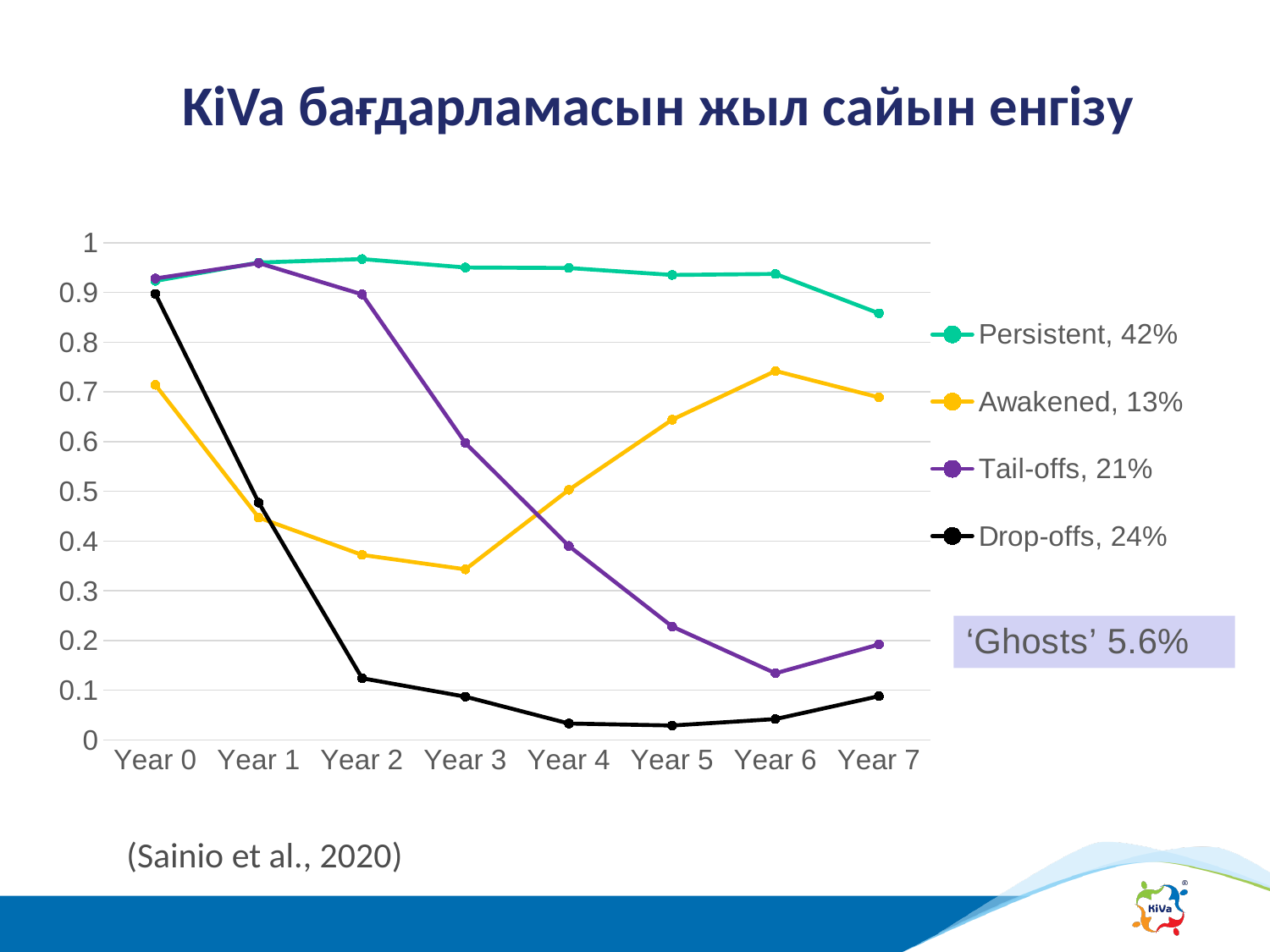
At Year 7, which series has the larger value, Persistent or Drop-offs? Persistent What kind of chart is shown on the slide? line chart Which series has the highest value at Year 5? Persistent Which series has the lowest value at Year 7? Drop-offs Do the values for Drop-offs rise or fall from Year 0 to Year 4? fall What percentage is shown next to Persistent in the legend? 42% Is the value for Tail-offs at Year 3 greater or less than 0.5? greater How many series does the legend list? 4 Is the value for Awakened at Year 6 greater or less than 0.7? greater How many year categories are shown on the x axis? 8 At Year 4, which series has the larger value, Awakened or Tail-offs? Awakened Is the value for Drop-offs at Year 2 greater or less than 0.2? less